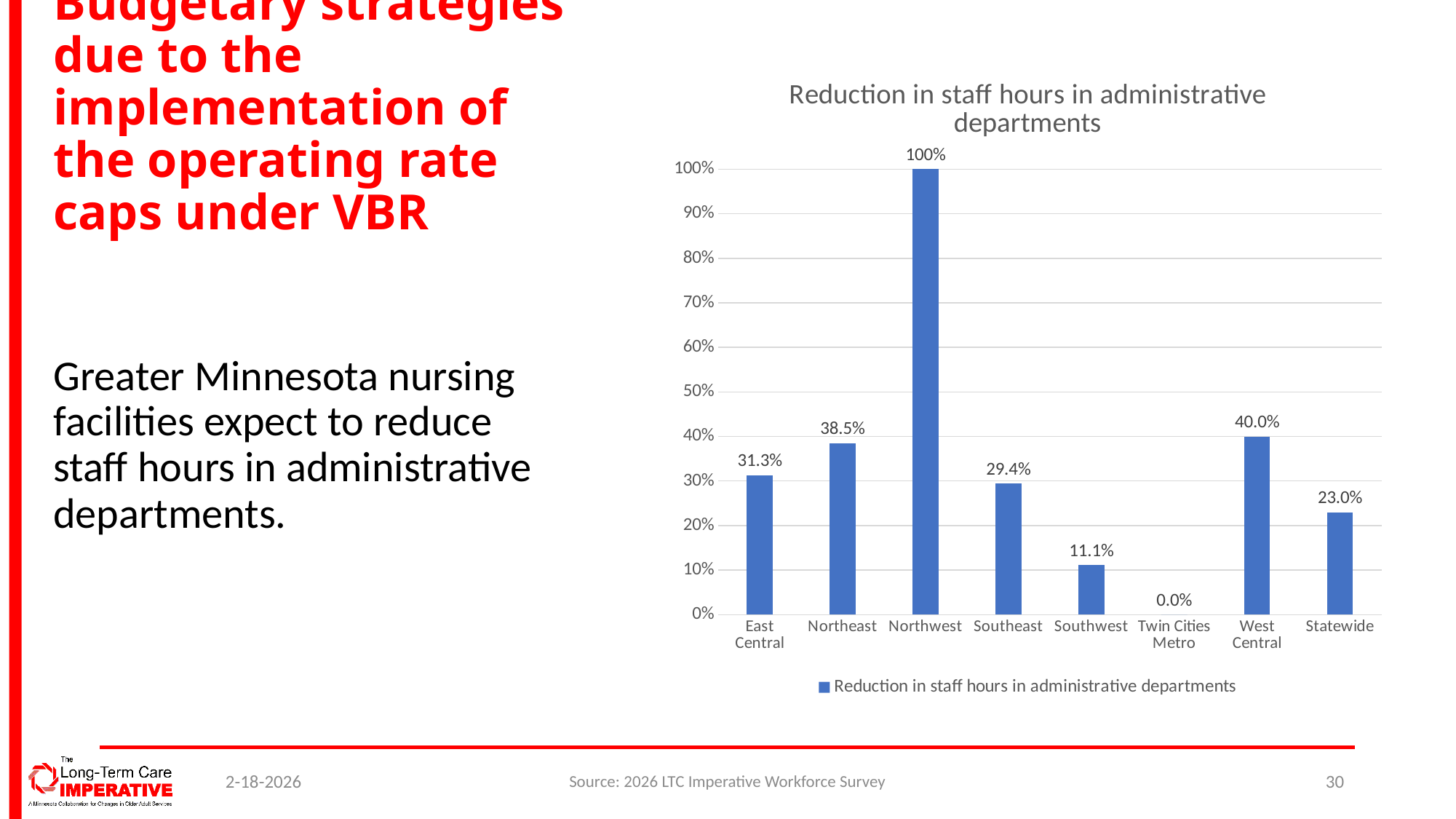
What is the value for Southwest in the chart? 11.1% Which region has the lowest reduction in staff hours in administrative departments? Twin Cities Metro Which region has the highest reduction in staff hours in administrative departments? Northwest What is the difference between the values for West Central and East Central? 8.7% What is the value for Northeast in the chart? 38.5% What kind of chart is shown on the slide? Bar chart What is the title of the chart? Reduction in staff hours in administrative departments Which is larger, the value for Southeast or the value for Statewide? Southeast What is the value for Twin Cities Metro in the chart? 0.0% How many regions are shown on the x axis of the chart? 8 Is the value for East Central greater or less than 30%? greater What is the value for Statewide in the chart? 23.0%